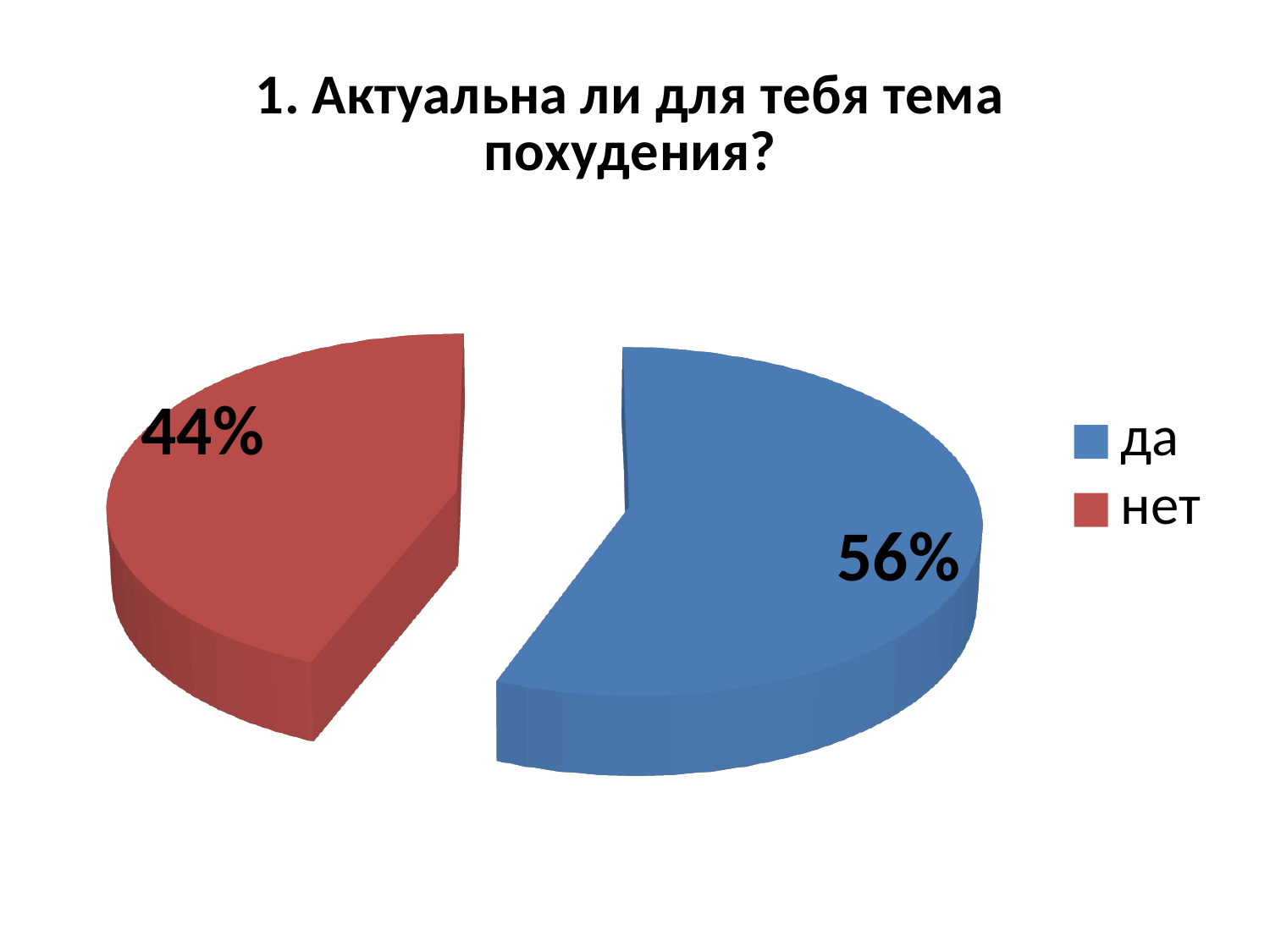
How many categories are shown in the pie chart? 2 Which category has the largest slice of the pie? да What colour is the "нет" slice in the pie chart? red What share of the pie does the "нет" slice represent? 44% What is the title of the chart? 1. Актуальна ли для тебя тема похудения? Which category has the smallest slice of the pie? нет What kind of chart is shown on the slide? pie chart Which slice is larger, "да" or "нет"? да What is the difference in percentage points between the "да" and "нет" slices? 12% Is the share for "да" greater or less than 50%? greater What is the total of the two slices shown in the pie chart? 100% What share of the pie does the "да" slice represent? 56%